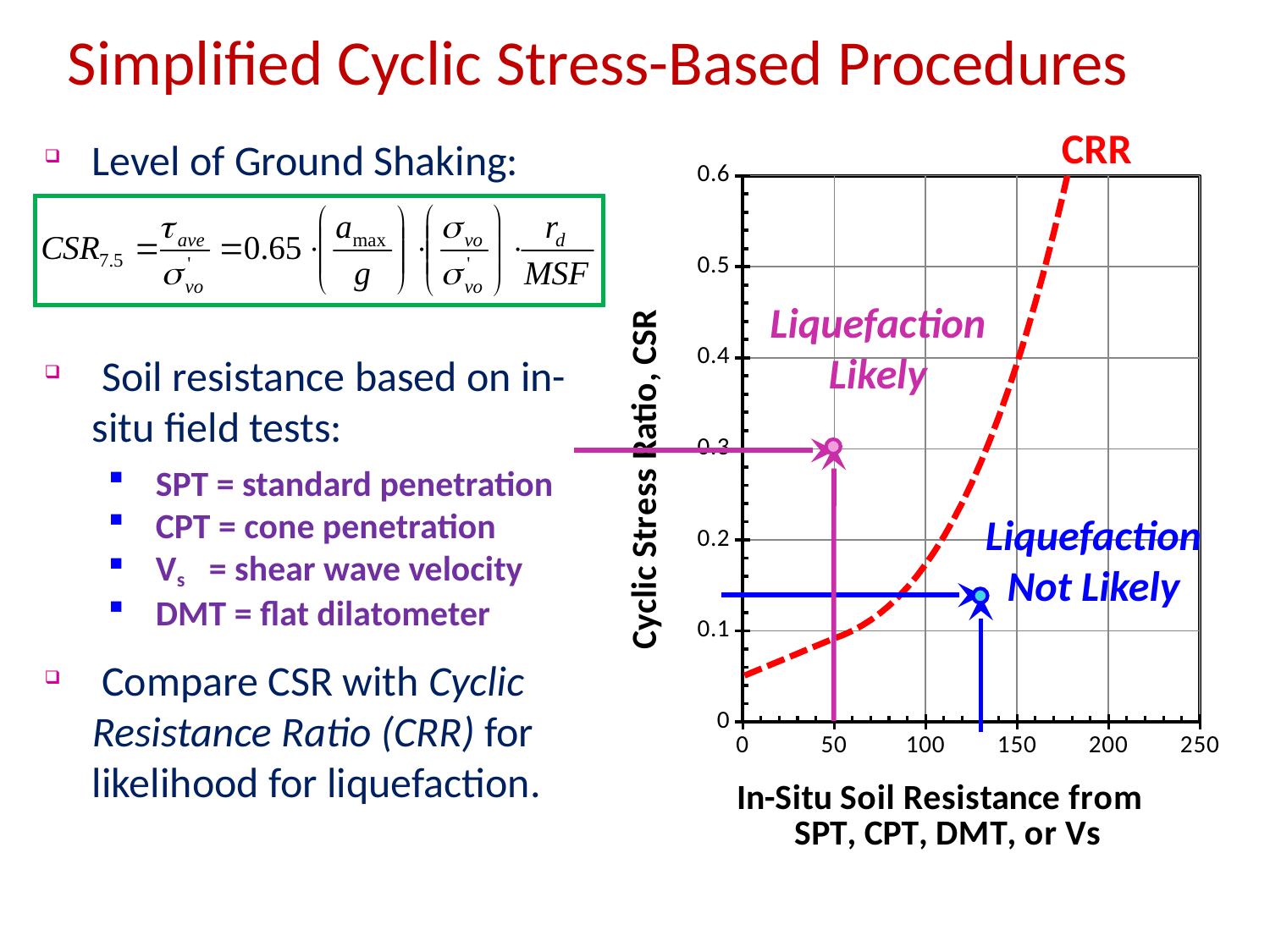
Is the CRR curve value at a soil resistance of 100 greater or less than 0.2? less Is the soil resistance of the point in the 'Liquefaction Not Likely' region greater or less than 100? greater Is the CSR of the point in the 'Liquefaction Not Likely' region greater or less than 0.2? less How many individual data points are marked on the chart in addition to the CRR curve? 2 Which marked point has the higher CSR, the one in the 'Liquefaction Likely' region or the one in the 'Liquefaction Not Likely' region? Liquefaction Likely What is the label of the x axis of the chart? In-Situ Soil Resistance from SPT, CPT, DMT, or Vs What kind of chart is shown on the slide? line chart What is the label of the y axis of the chart? Cyclic Stress Ratio, CSR What is the highest value shown on the y axis of the chart? 0.6 Does the CRR curve rise or fall as in-situ soil resistance increases along the x axis? rise